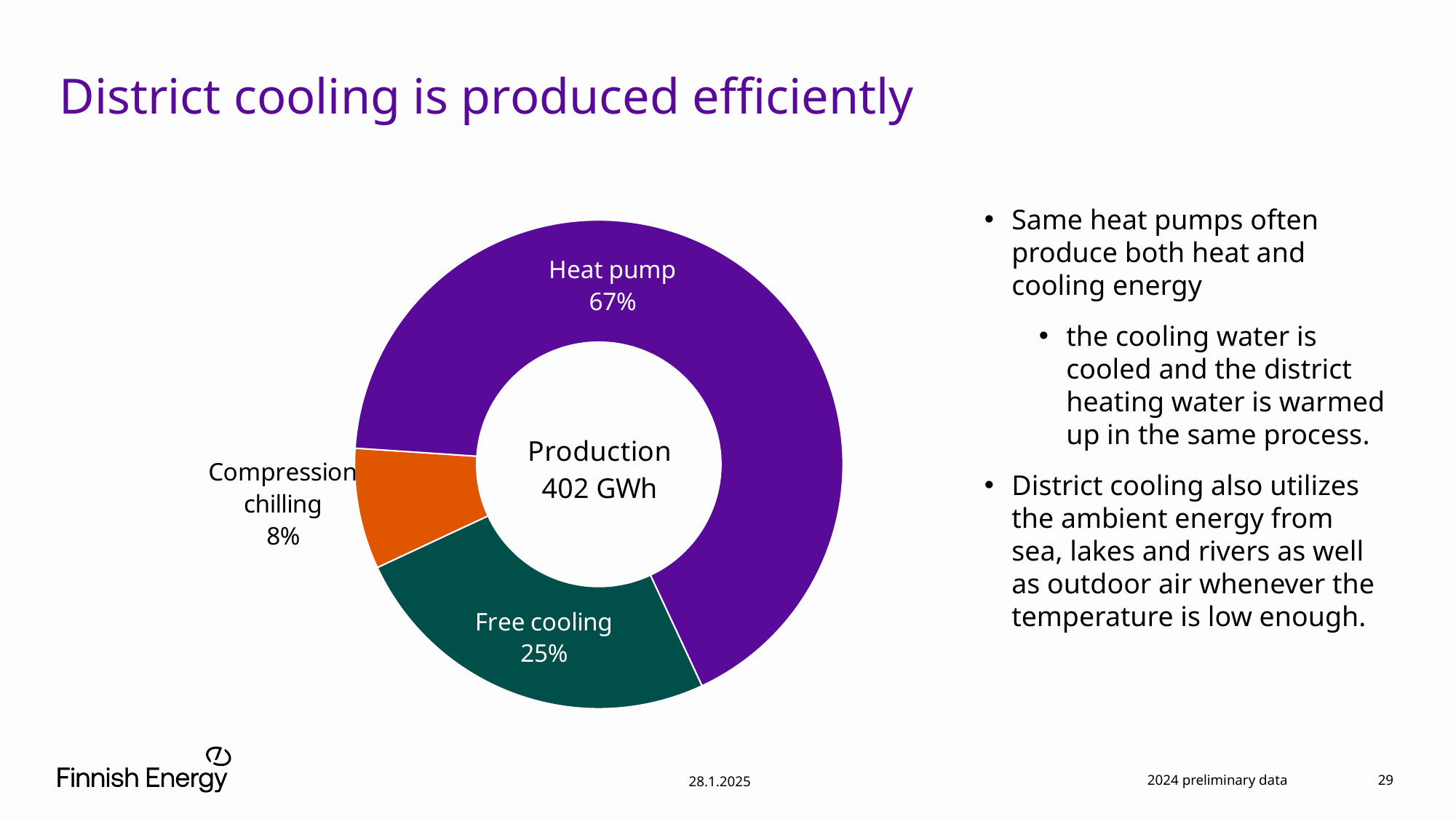
Which production method has the largest share of the chart? Heat pump What total production value is shown in the centre of the chart? 402 GWh Which production method has the smallest share of the chart? Compression chilling What share of production is compression chilling? 8% What share of production is free cooling? 25% What share of district cooling production comes from heat pumps? 67% How many percentage points larger is the heat pump share than the free cooling share? 42 What kind of chart is shown on the slide? Doughnut (pie) chart How many production methods are shown in the chart? 3 What colour is the free cooling segment of the chart? Dark green What is the difference in percentage points between free cooling and compression chilling? 17 Which has a larger share, free cooling or compression chilling? Free cooling